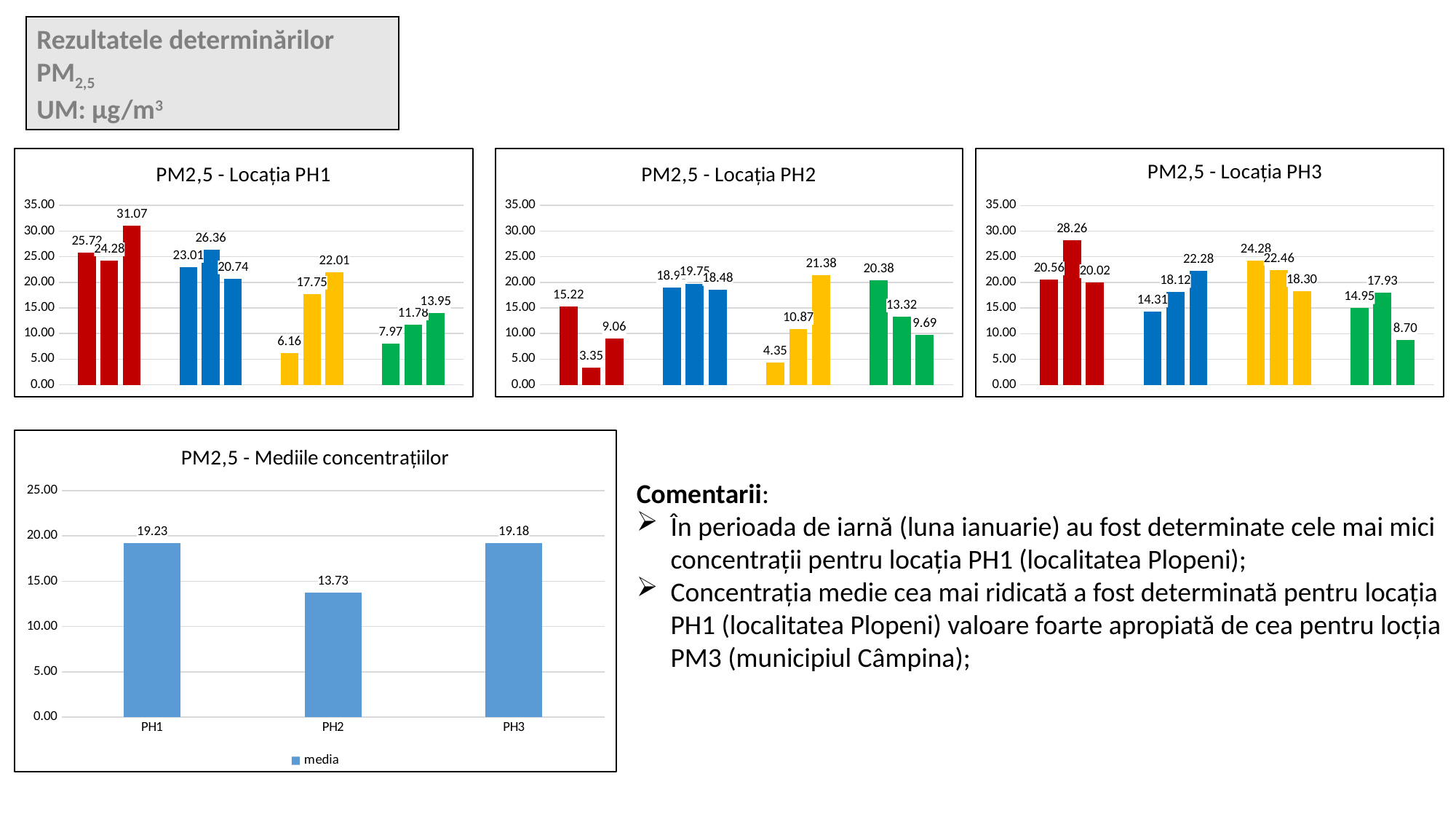
In the PM2,5 - Mediile concentrațiilor chart, how many locations are shown on the x axis? 3 In the PM2,5 - Locația PH2 chart, what is the lowest value shown? 3.35 In the PM2,5 - Locația PH1 chart, what is the highest value shown? 31.07 In the PM2,5 - Locația PH1 chart, what is the lowest value shown? 6.16 In the PM2,5 - Mediile concentrațiilor chart, how many series does the legend list? 1 What kind of chart is PM2,5 - Mediile concentrațiilor? bar chart In the PM2,5 - Locația PH3 chart, what is the highest value shown? 28.26 In the PM2,5 - Mediile concentrațiilor chart, what is the difference between the values for PH1 and PH2? 5.50 In the PM2,5 - Mediile concentrațiilor chart, which location has the lowest value? PH2 In the PM2,5 - Mediile concentrațiilor chart, what is the value for PH1? 19.23 In the PM2,5 - Mediile concentrațiilor chart, what is the value for PH2? 13.73 In the PM2,5 - Mediile concentrațiilor chart, what is the name of the series in the legend? media